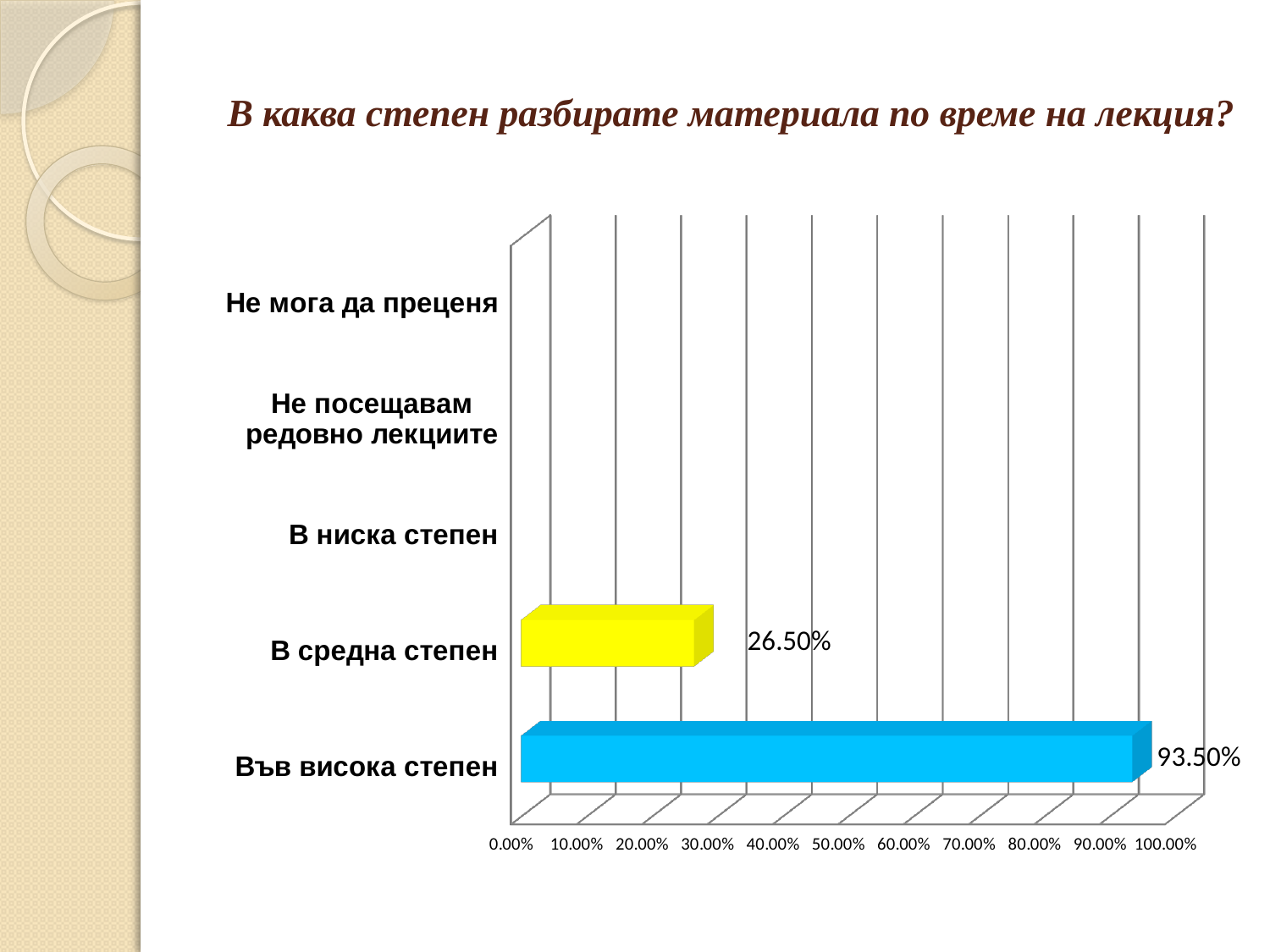
How many categories are listed on the vertical axis of the chart? 5 What is the difference between the values for "Във висока степен" and "В средна степен"? 67.00% What colour is the bar for "В средна степен"? yellow Which category has the highest value? Във висока степен What type of chart is shown on the slide? bar chart Is the value for "В средна степен" greater or less than 30.00%? less What is the title of the slide above the chart? В каква степен разбирате материала по време на лекция? What is the value for "В средна степен"? 26.50% Is the value for "Във висока степен" greater or less than 90.00%? greater Which is larger, the value for "В средна степен" or the value for "Във висока степен"? Във висока степен What is the value for "Във висока степен"? 93.50% What is the highest tick label shown on the horizontal axis? 100.00%